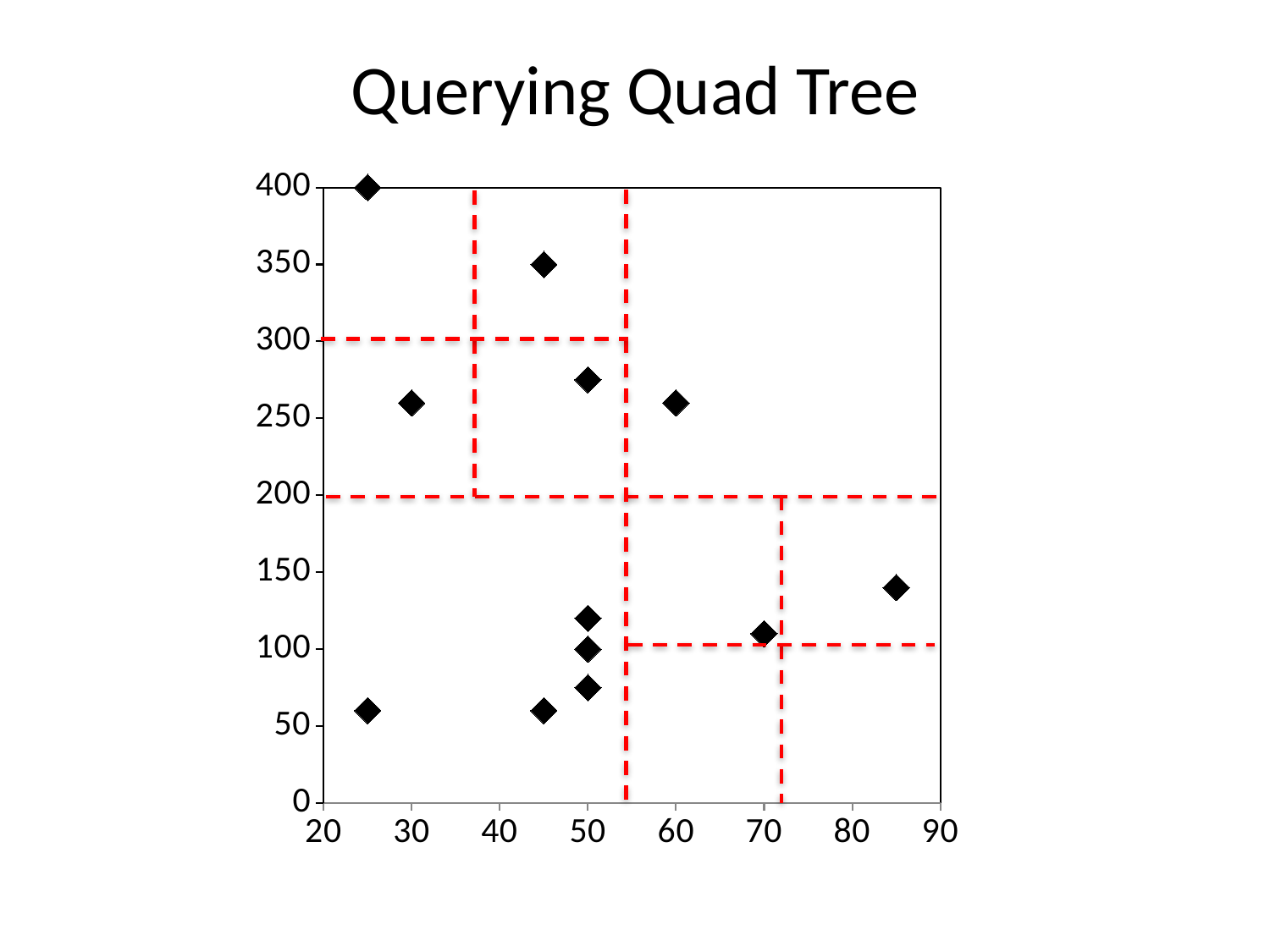
Is the y value of the lower point near x = 25 greater or less than 100? less What is the maximum value shown on the y axis? 400 Is the y value of the topmost point (near x = 25) greater or less than 350? greater How many data points are plotted on the chart? 12 What is the title of the chart? Querying Quad Tree How many data points lie below the y value of 200? 7 Is the y value of the point near x = 30 greater or less than 200? greater Which has the larger y value: the point near x = 45 at the top of the chart or the point near x = 60? the point near x = 45 How many data points lie above the y value of 300? 2 What kind of chart is shown on the slide? scatter chart